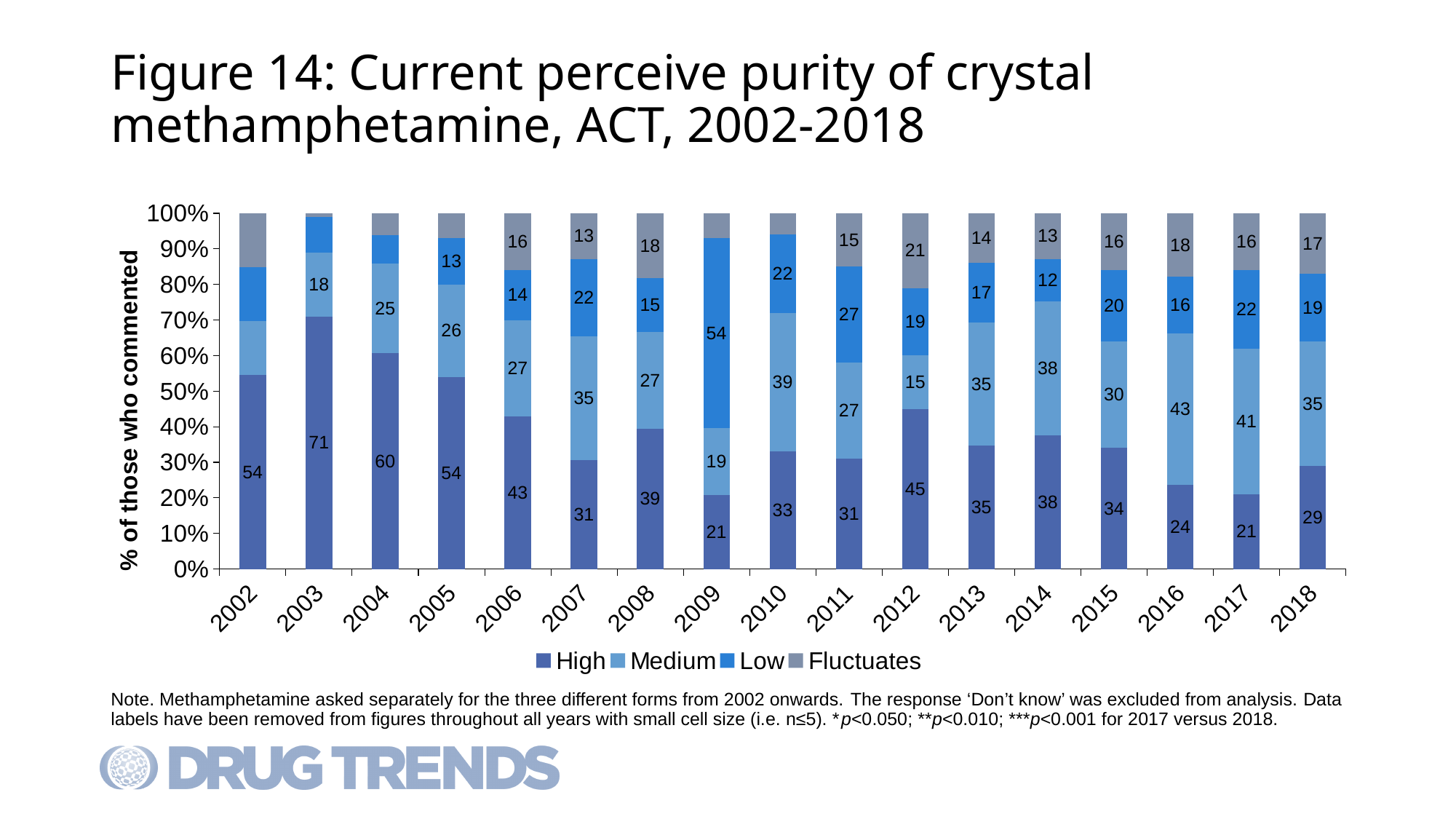
What is the value of the Fluctuates series for 2012? 21 What is the value of the Medium series for 2016? 43 In which year is the Low series at its highest? 2009 In which year is the High series at its highest? 2003 What is the label of the y axis? % of those who commented What kind of chart is shown on the slide? Stacked bar chart How many series does the legend list? 4 What is the value of the High series for 2003? 71 What is the value of the Low series for 2009? 54 What is the difference between the High values for 2018 and 2017? 8 How many years are shown on the x axis? 17 Which year has the larger Medium value, 2016 or 2018? 2016